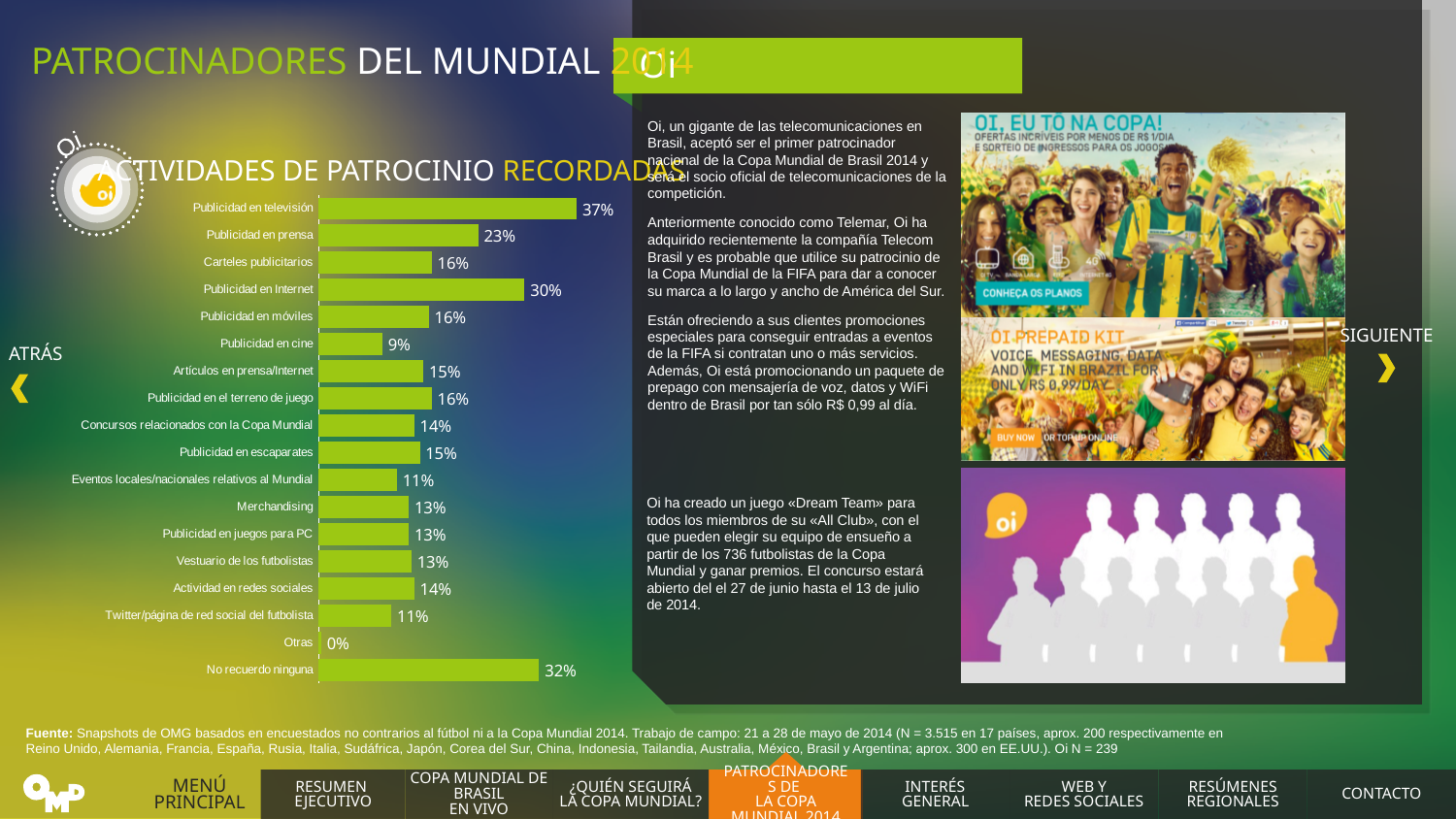
What kind of chart is shown on the slide? Bar chart What is the title of the chart? ACTIVIDADES DE PATROCINIO RECORDADAS How many categories are shown in the chart? 18 What value is shown for No recuerdo ninguna? 32% Which category has the highest value? Publicidad en televisión Which category has the lowest value? Otras What is the difference between Publicidad en televisión and Publicidad en prensa? 14% What value is shown for Publicidad en televisión? 37% Which is larger, Publicidad en prensa or Merchandising? Publicidad en prensa What is the difference between Publicidad en Internet and Publicidad en cine? 21% What value is shown for Publicidad en cine? 9% What value is shown for Publicidad en Internet? 30%